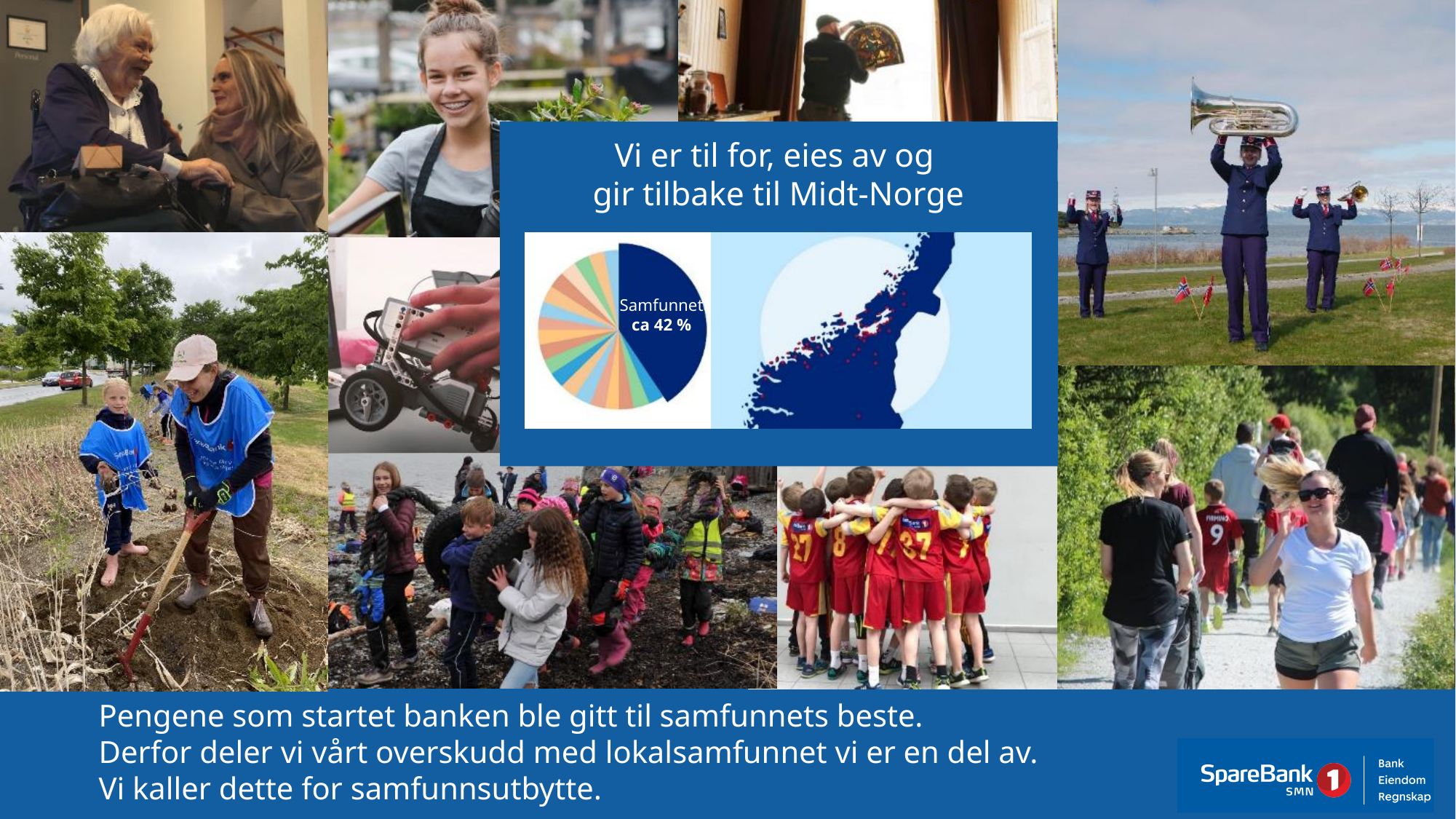
Which slice of the pie chart has a printed label? Samfunnet Which slice of the pie chart is the largest? Samfunnet What is the value printed on the Samfunnet slice of the pie chart? ca 42 % What share of the pie chart is labelled for Samfunnet? ca 42 % What kind of chart is shown on the slide? pie chart What colour is the Samfunnet slice in the pie chart? dark blue